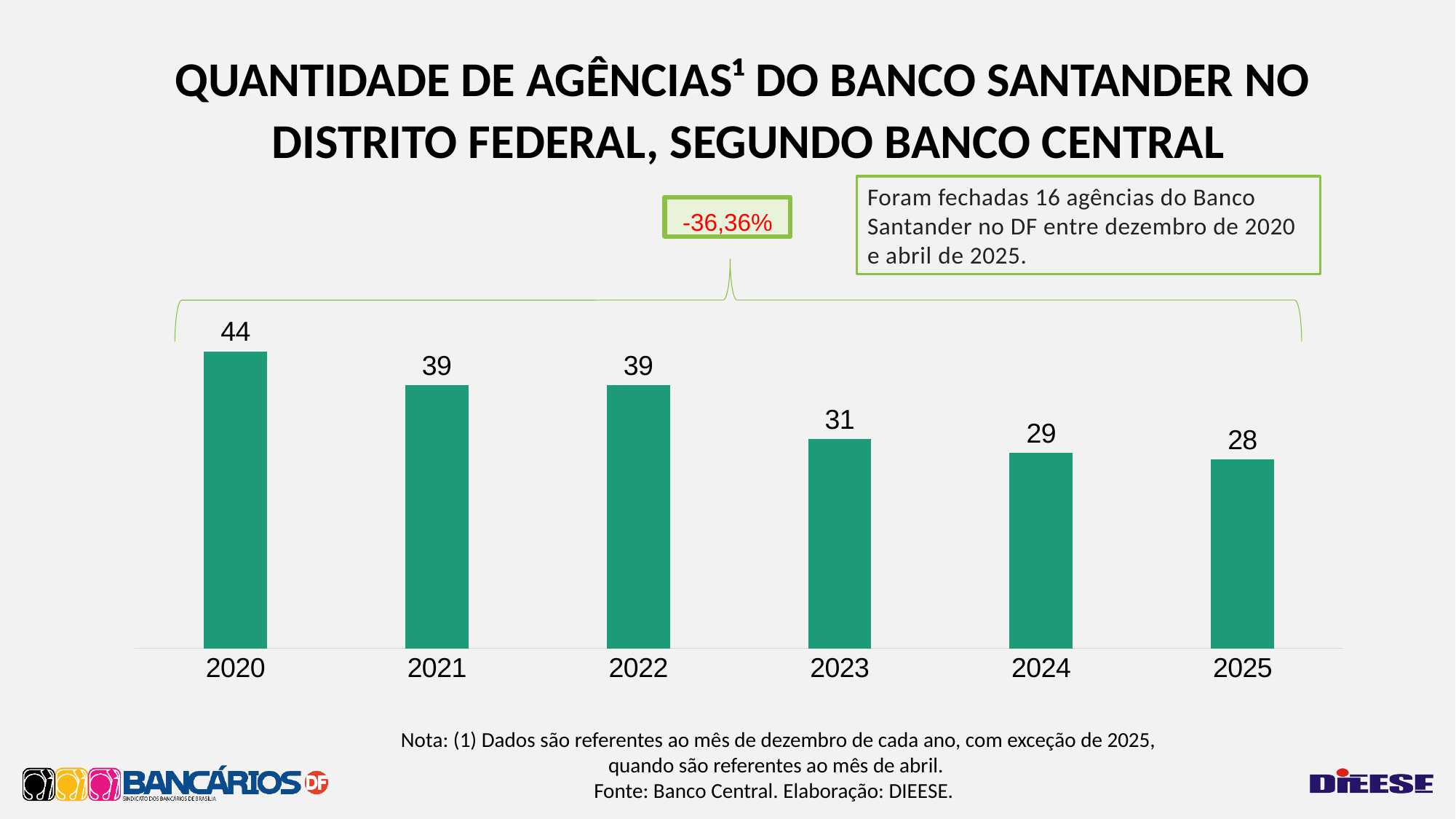
What kind of chart is this? bar chart Which year has the lowest number of branches? 2025 What is the difference between the values for 2022 and 2023? 8 What is the value shown for 2025? 28 How many years are shown on the x axis? 6 What is the difference between the values for 2020 and 2025? 16 Which is larger, the value for 2021 or the value for 2024? 2021 What is the value shown for 2023? 31 How many Santander branches were there in the Distrito Federal in 2020? 44 Do the values generally rise or fall from 2020 to 2025? fall What percentage change is shown in the label above the bracket? -36,36% Which year has the highest number of branches? 2020